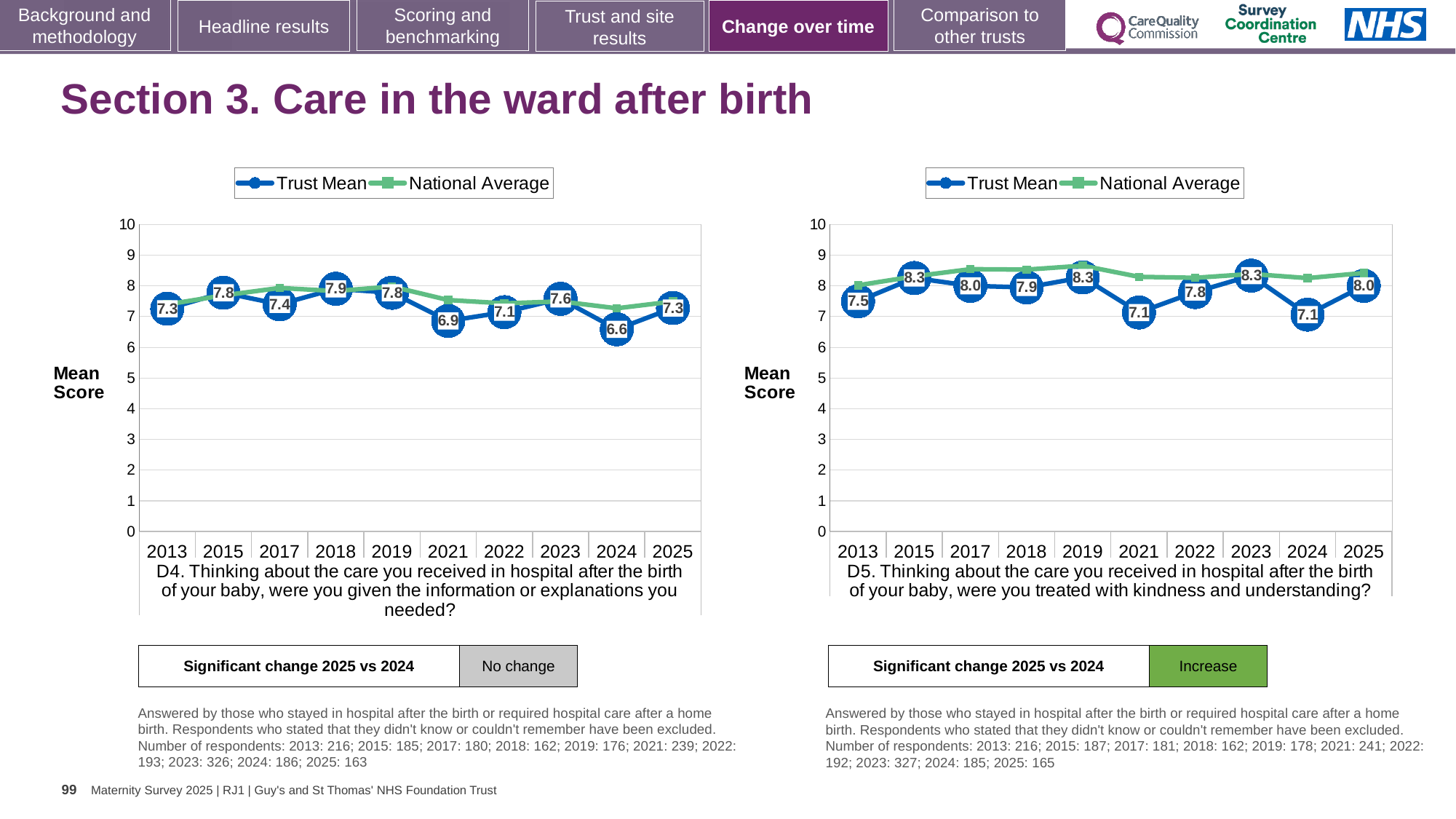
What does the 'Significant change 2025 vs 2024' box under the right chart (D5) say? Increase How many series does the legend of the right chart (D5) list? 2 In the left chart (D4), is the Trust Mean higher in 2015 or in 2017? 2015 What kind of chart is the left chart (D4)? Line chart In the left chart (D4), which year has the lowest Trust Mean? 2024 In the right chart (D5), what is the Trust Mean for 2013? 7.5 In the left chart (D4), which year has the highest Trust Mean? 2018 How many years are plotted on the x axis of the left chart (D4)? 10 In the left chart (D4), did the Trust Mean rise or fall from 2023 to 2024? Fall In the right chart (D5), what is the difference between the Trust Mean in 2025 and in 2024? 0.9 In the right chart (D5), is the National Average for 2019 greater or less than 8? greater In the left chart (D4), what is the Trust Mean for 2024? 6.6